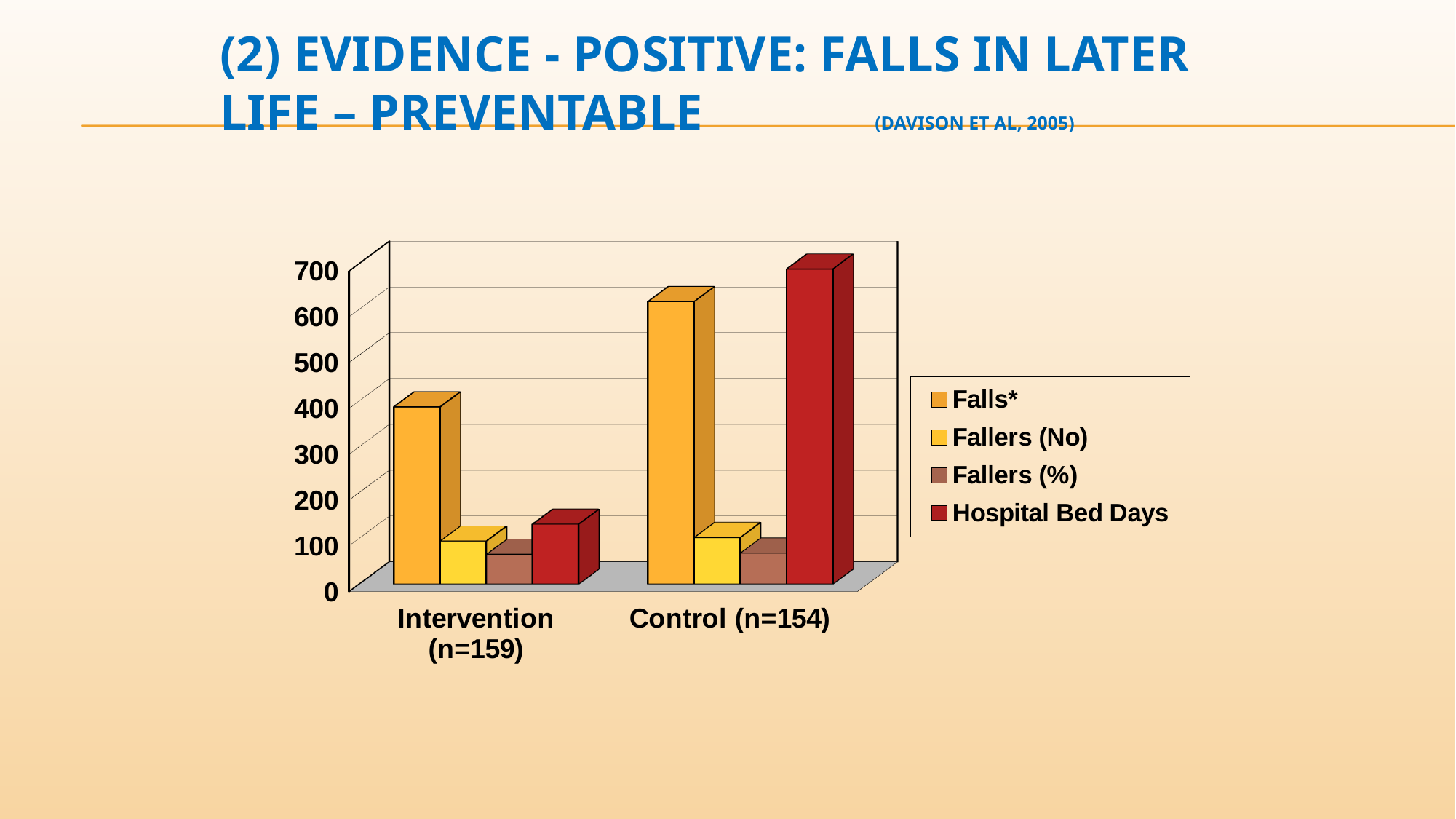
Which series has the shortest bar in the Intervention (n=159) group? Fallers (%) How many groups (categories) are shown on the x axis? 2 What kind of chart is shown on the slide? Bar chart Is the Hospital Bed Days value for Control (n=154) greater or less than 600? greater Is the Hospital Bed Days value for Intervention (n=159) greater or less than 200? less Which series has the tallest bar in the Control (n=154) group? Hospital Bed Days Which series is shown in dark red in the legend? Hospital Bed Days Which group has the larger Hospital Bed Days value, Intervention (n=159) or Control (n=154)? Control (n=154) How many series does the legend list? 4 Is the Falls* value for Intervention (n=159) greater or less than 300? greater Which series has the tallest bar in the Intervention (n=159) group? Falls*